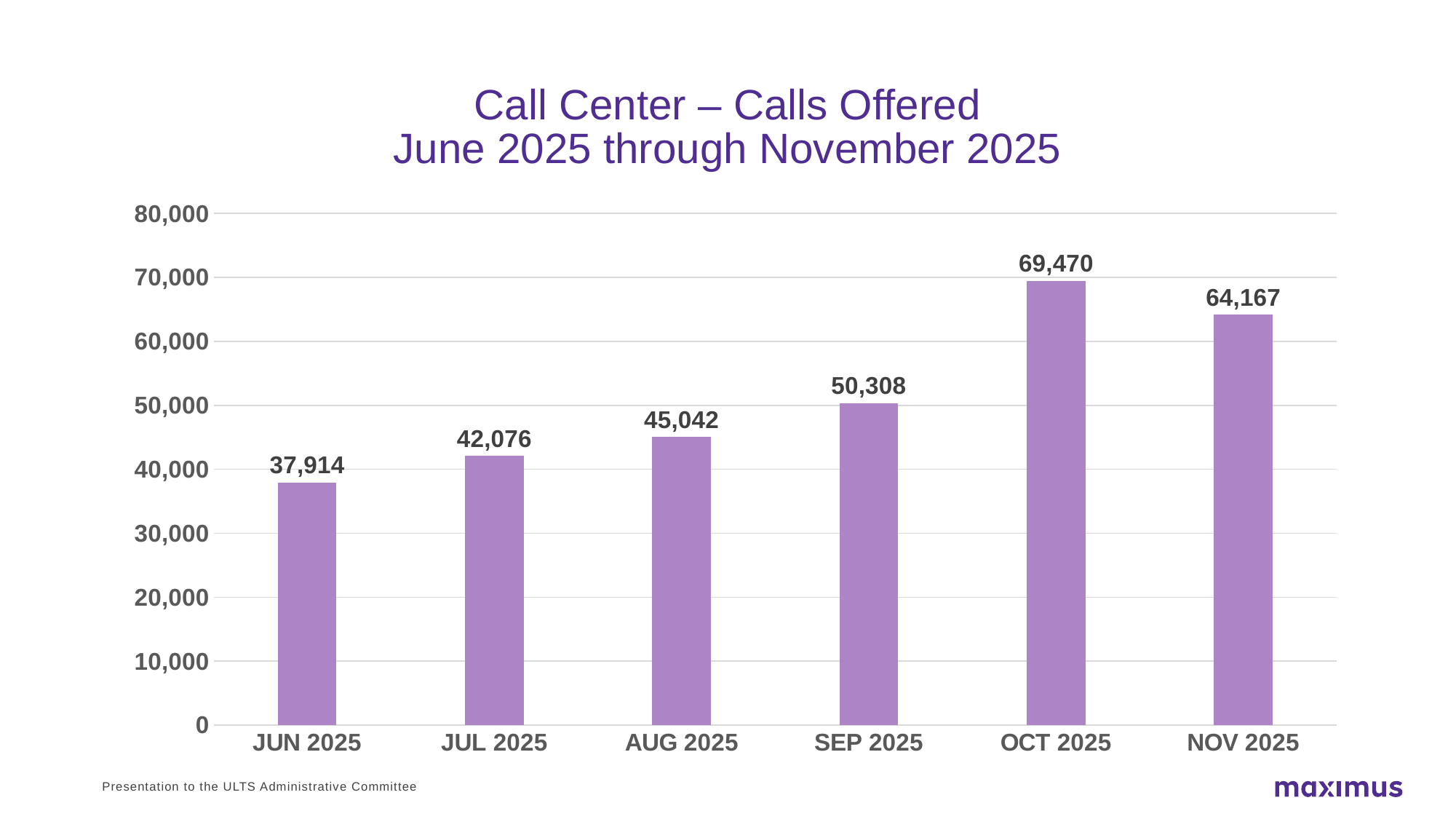
What is the difference between the calls offered in JUL 2025 and JUN 2025? 4,162 Which month has the highest number of calls offered? OCT 2025 How many months are shown on the chart? 6 What is the difference between the calls offered in OCT 2025 and NOV 2025? 5,303 What is the title of the chart? Call Center – Calls Offered June 2025 through November 2025 What is the value for JUN 2025? 37,914 Which month has the lowest number of calls offered? JUN 2025 How many calls were offered in SEP 2025? 50,308 Is the value for NOV 2025 greater or less than 60,000? greater Do the values rise or fall from JUN 2025 to OCT 2025? Rise What kind of chart is shown on the slide? Bar chart Which month had more calls offered, AUG 2025 or SEP 2025? SEP 2025